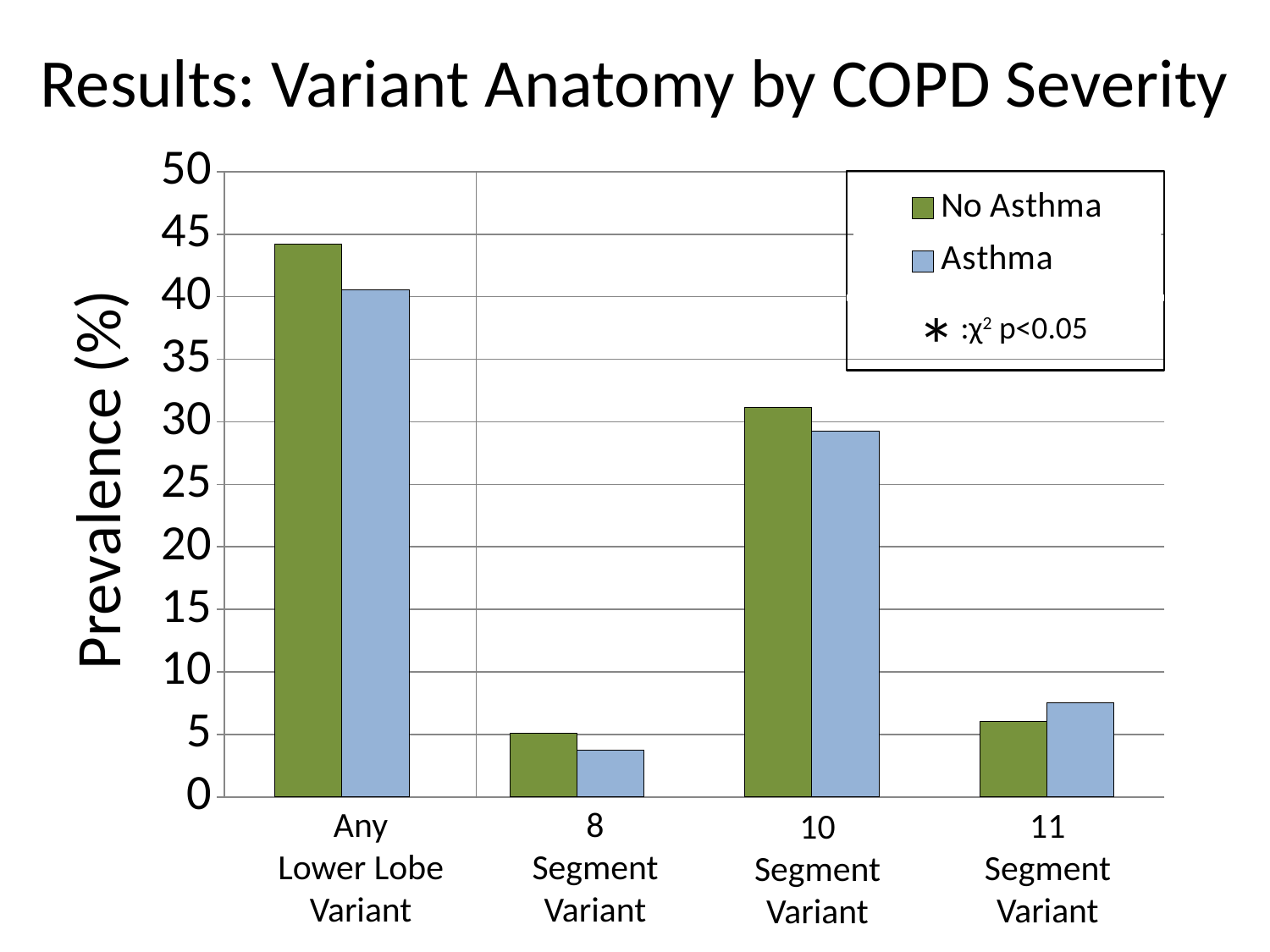
How many series does the legend list? 2 Is the Asthma value for 11 Segment Variant greater or less than 5? greater For Any Lower Lobe Variant, which series has the larger prevalence, No Asthma or Asthma? No Asthma Which category has the lowest prevalence for the Asthma series? 8 Segment Variant What kind of chart is shown on the slide? bar chart How many variant categories are shown on the x axis? 4 Is the No Asthma value for 8 Segment Variant greater or less than 10? less Which category has the highest prevalence for the No Asthma series? Any Lower Lobe Variant Is the No Asthma value for Any Lower Lobe Variant greater or less than 40? greater For 11 Segment Variant, which series has the larger prevalence, No Asthma or Asthma? Asthma What is the label on the y axis of the chart? Prevalence (%)